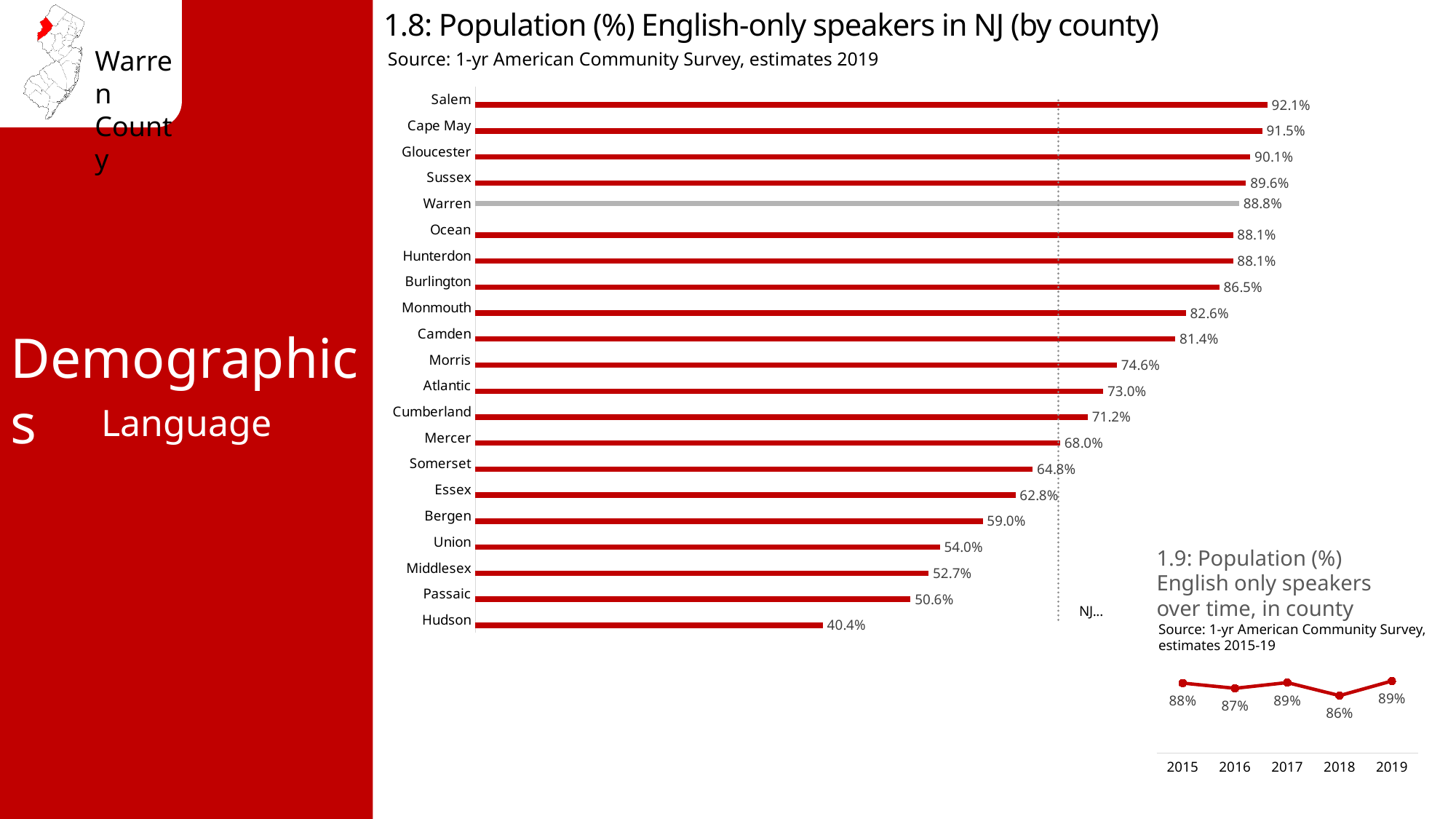
In chart 1.8, what is the difference between the values for Salem and Hudson? 51.7% In chart 1.8, which county has the highest value? Salem What kind of chart is chart 1.9? Line chart What kind of chart is chart 1.8? Bar chart In chart 1.9, what is the value for 2018? 86% In chart 1.8, which county's bar is shown in grey rather than red? Warren In chart 1.8, how many counties are plotted? 21 In chart 1.9, how many years are plotted? 5 In chart 1.8, which county has the lowest value? Hudson In chart 1.8, which is larger, the value for Morris or the value for Atlantic? Morris In chart 1.8, what is the value for Warren? 88.8% In chart 1.8, what is the value for Hudson? 40.4%